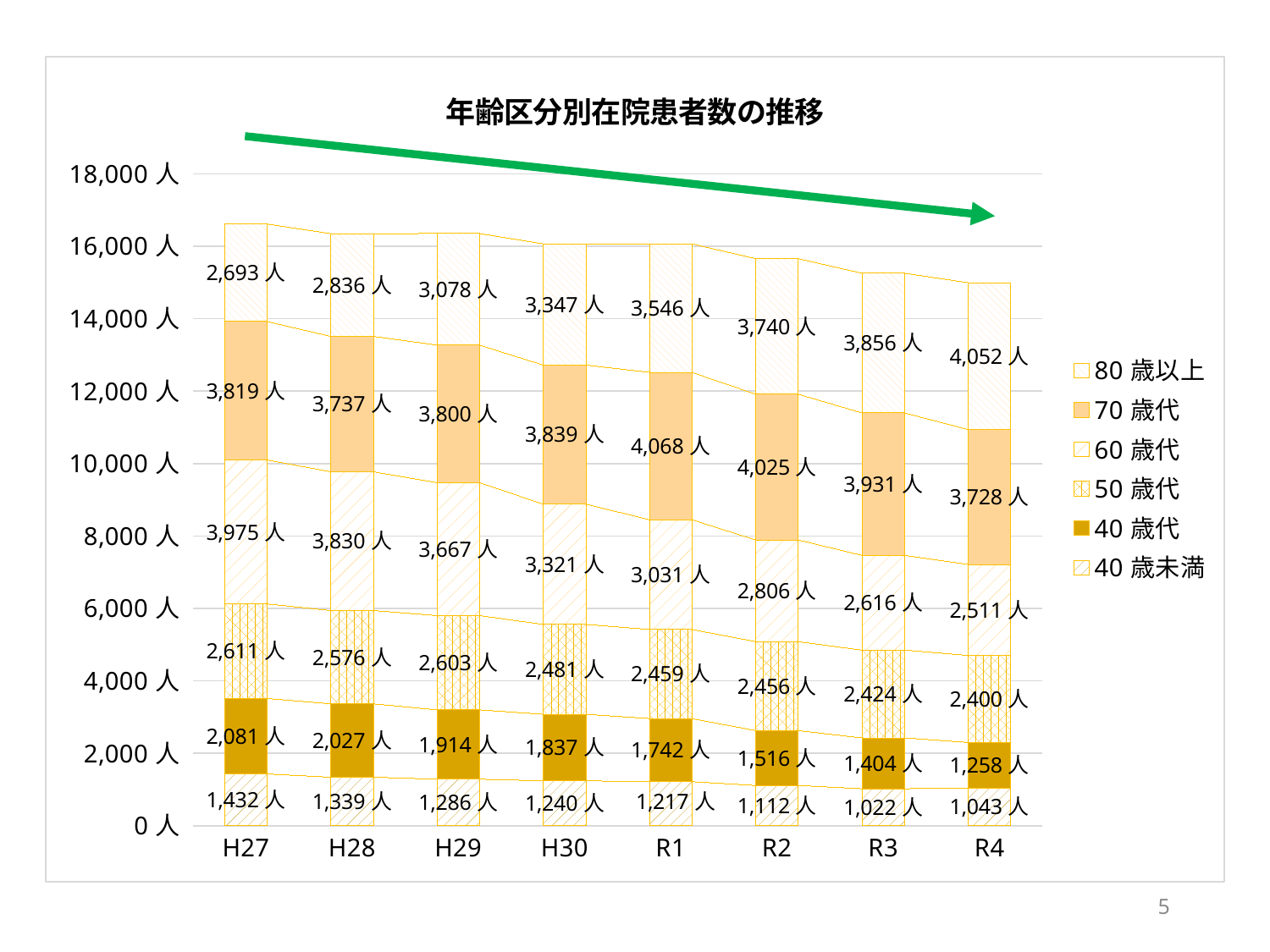
How many series does the legend list? 6 What is the title of the chart? 年齢区分別在院患者数の推移 What kind of chart is this? Stacked bar chart Which is larger, the 60 歳代 value in H27 or in R4? H27 In which year is the 80 歳以上 value the highest? R4 What is the difference between the 70 歳代 value in R1 and in H27? 249 人 Do the 40 歳代 values rise or fall from H27 to R4? Fall What is the value for 80 歳以上 in R4? 4,052 人 In which year is the 40 歳未満 value the lowest? R3 What is the value for 40 歳代 in H27? 2,081 人 How many years are shown on the x axis? 8 What is the total of the stacked bar for H27? 16,611 人